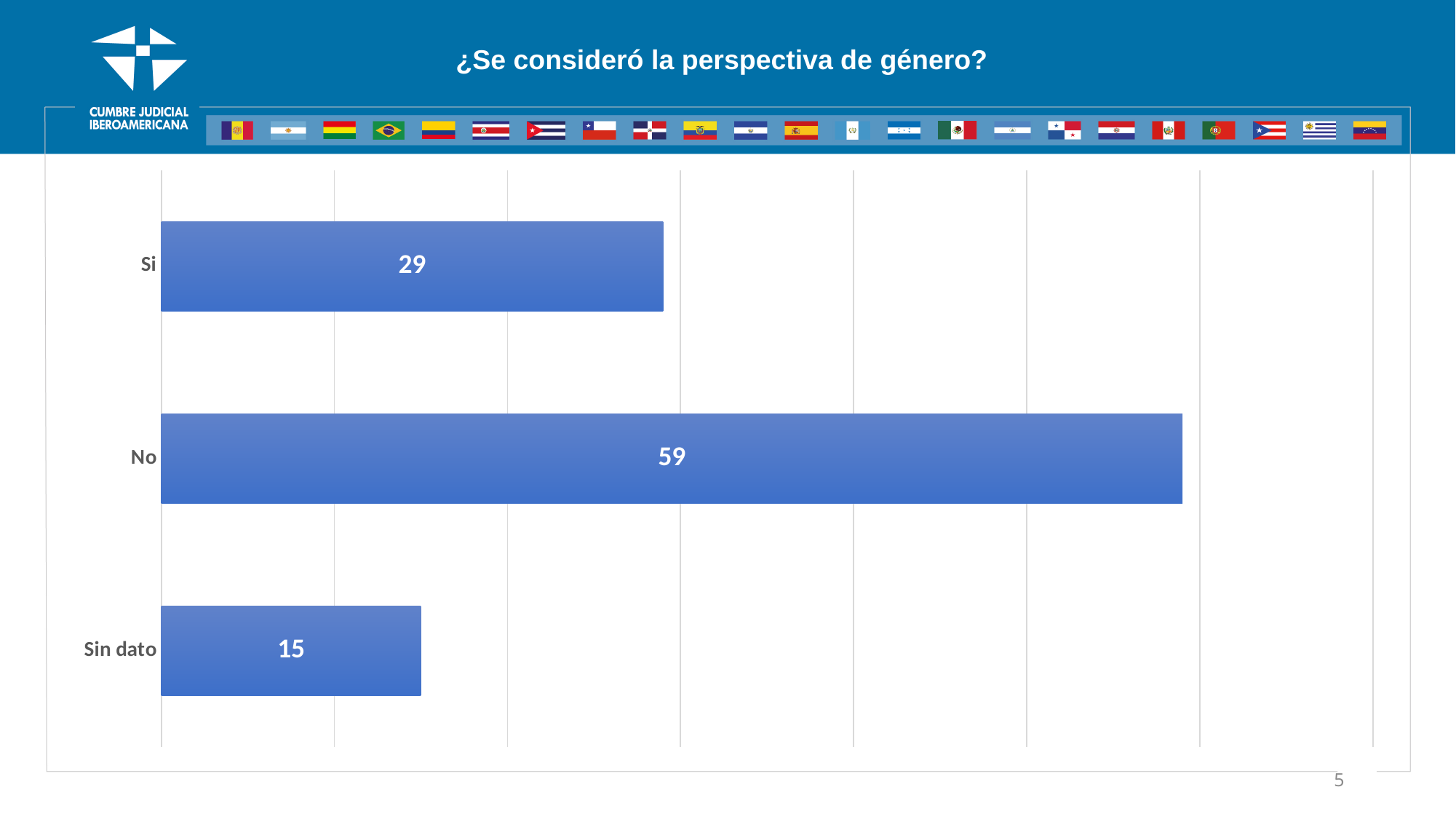
Which is larger, the value for "Si" or the value for "Sin dato"? Si What is the value for "No"? 59 What is the value for "Sin dato"? 15 What is the title of the chart? ¿Se consideró la perspectiva de género? Which category has the highest value? No What kind of chart is shown on the slide? Bar chart What is the difference between the values for "Si" and "Sin dato"? 14 What is the value for "Si"? 29 Which category has the lowest value? Sin dato What is the total of the three values shown in the chart? 103 How many categories are shown in the chart? 3 What is the difference between the values for "No" and "Si"? 30